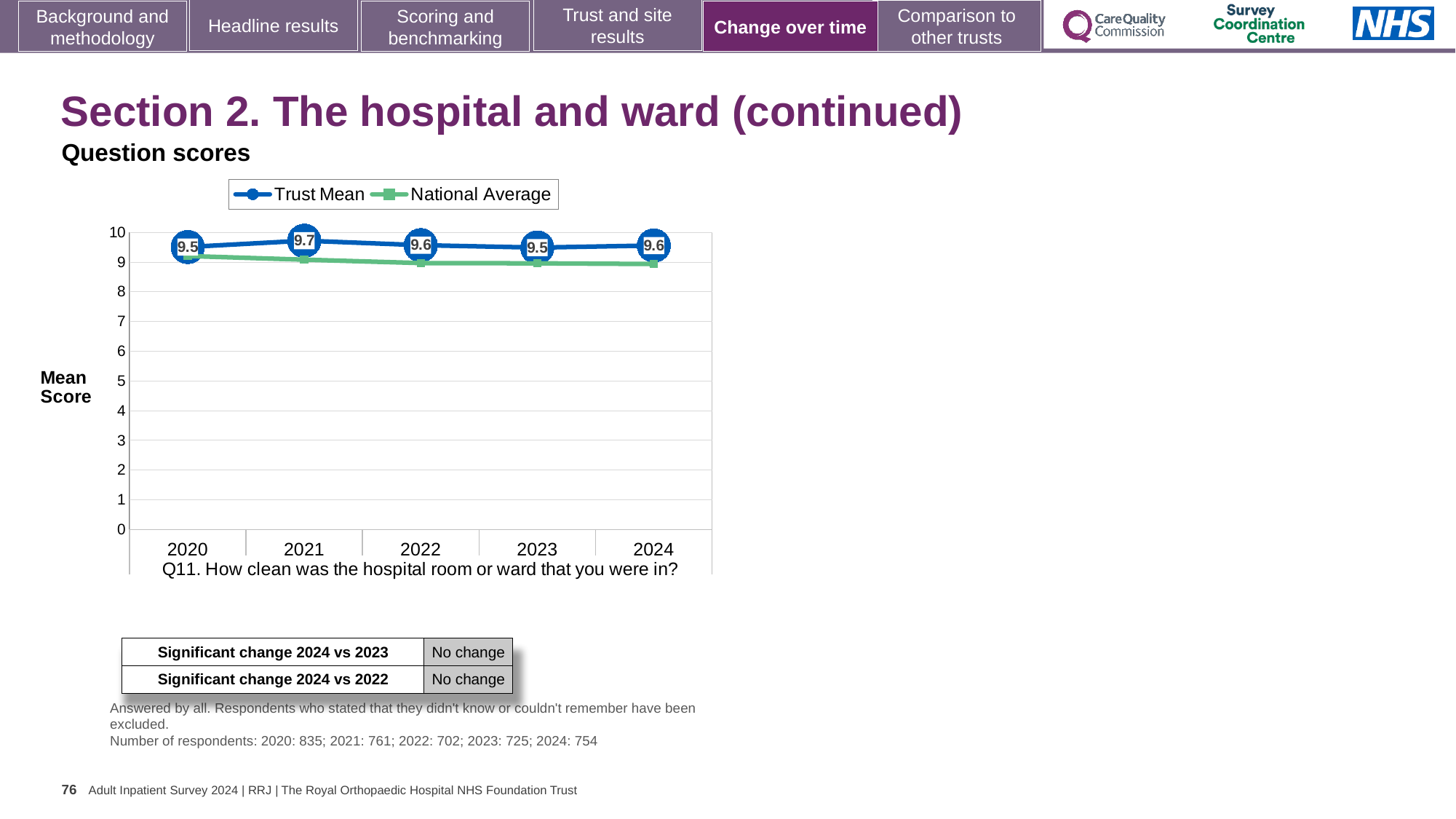
What is the Trust Mean score for 2021? 9.7 What kind of chart is shown on the slide? Line chart What is the difference between the Trust Mean scores for 2021 and 2020? 0.2 Which year has the larger Trust Mean score, 2021 or 2023? 2021 What is the Trust Mean score for 2024? 9.6 In which year is the Trust Mean score highest? 2021 How many series does the chart legend list? 2 What is the Trust Mean score for 2020? 9.5 Which survey question does the chart relate to? Q11. How clean was the hospital room or ward that you were in? How many years are shown on the x axis of the chart? 5 Is the National Average value for 2024 greater or less than 8? greater Which series is higher in 2022, Trust Mean or National Average? Trust Mean